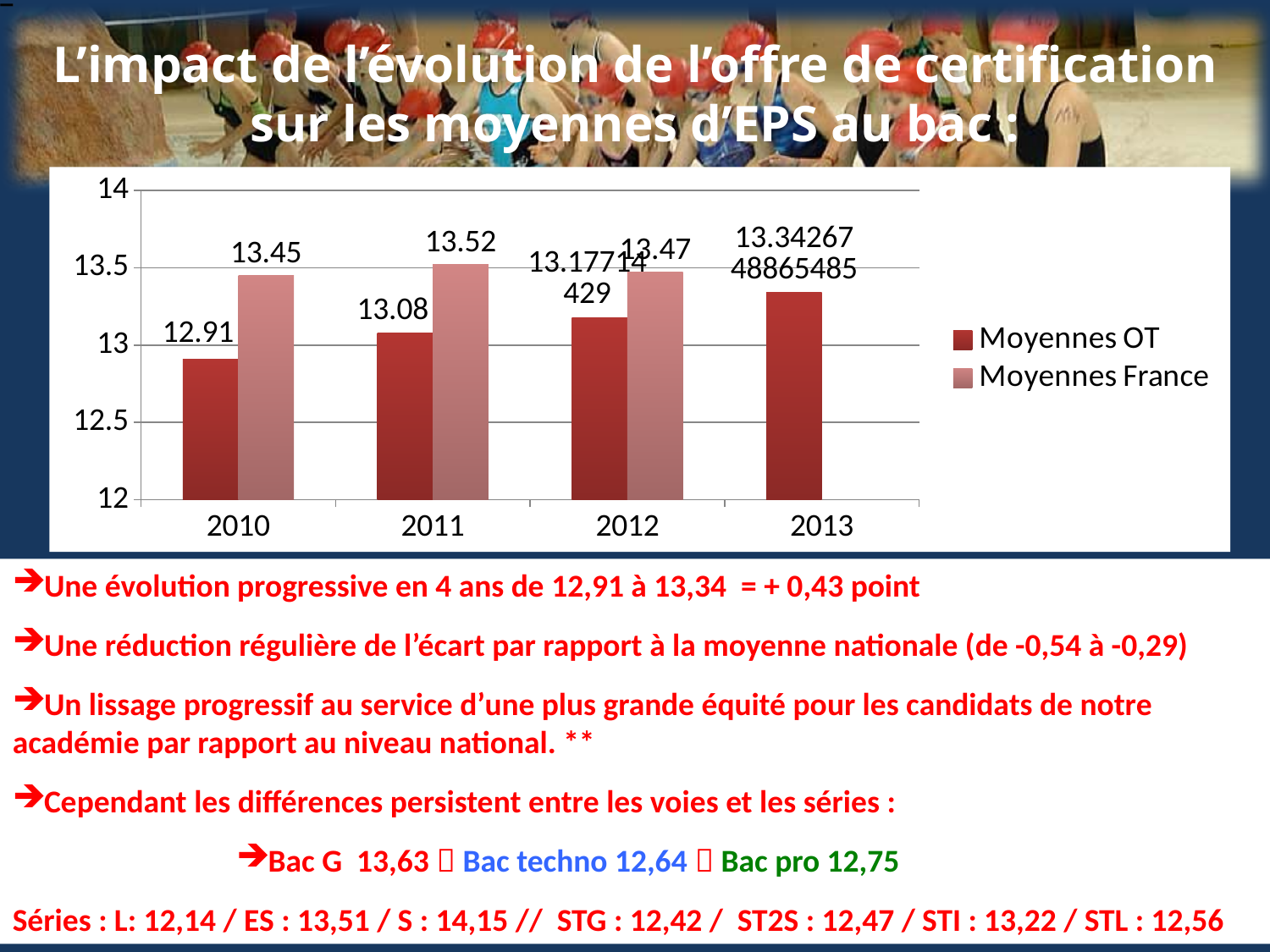
What is the value of Moyennes OT for 2011? 13.08 How many years are shown on the x axis of the chart? 4 Do the Moyennes OT values rise or fall from 2010 to 2013? Rise What is the value of Moyennes France for 2011? 13.52 In 2011, which is larger: Moyennes OT or Moyennes France? Moyennes France How many series does the chart legend list? 2 What kind of chart is shown on the slide? Bar chart What is the value of Moyennes OT for 2010? 12.91 What is the value of Moyennes France for 2010? 13.45 In which year is Moyennes OT lowest? 2010 What is the difference between Moyennes France and Moyennes OT in 2010? 0.54 Is the value of Moyennes OT for 2013 greater or less than 13.5? less